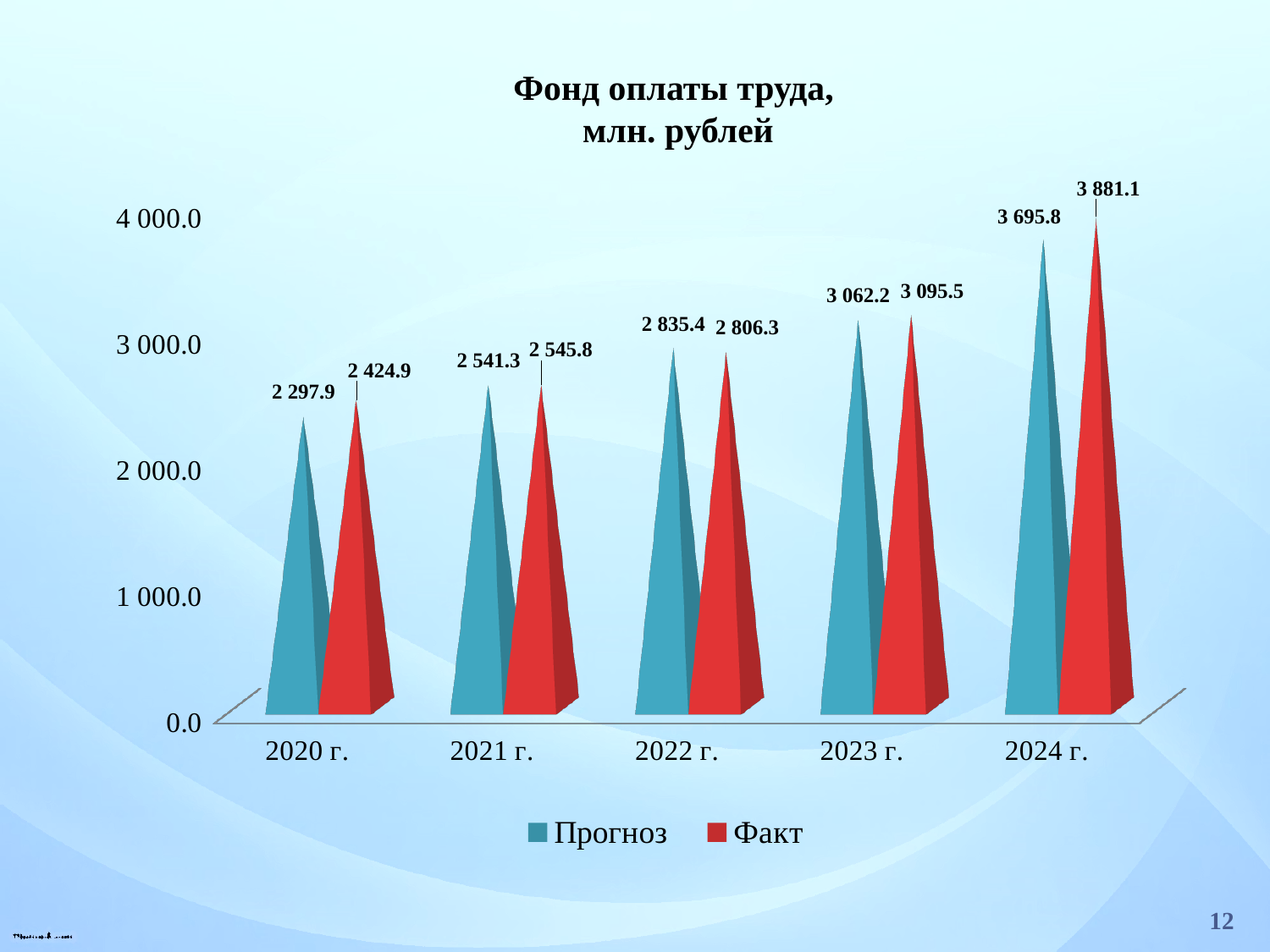
For 2022 г., which is larger: Прогноз or Факт? Прогноз Which year has the highest Факт value? 2024 г. What is the difference between the Факт and Прогноз values for 2024 г.? 185.3 What is the Прогноз value for 2020 г.? 2 297.9 What is the Факт value for 2023 г.? 3 095.5 How many series does the legend list? 2 How many years are shown on the x axis? 5 What is the Факт value for 2024 г.? 3 881.1 Which year has the lowest Прогноз value? 2020 г. Do the Факт values rise or fall from 2020 г. to 2024 г.? rise What is the difference between the Факт and Прогноз values for 2020 г.? 127.0 Is the Прогноз value for 2023 г. greater or less than 3 000.0? greater